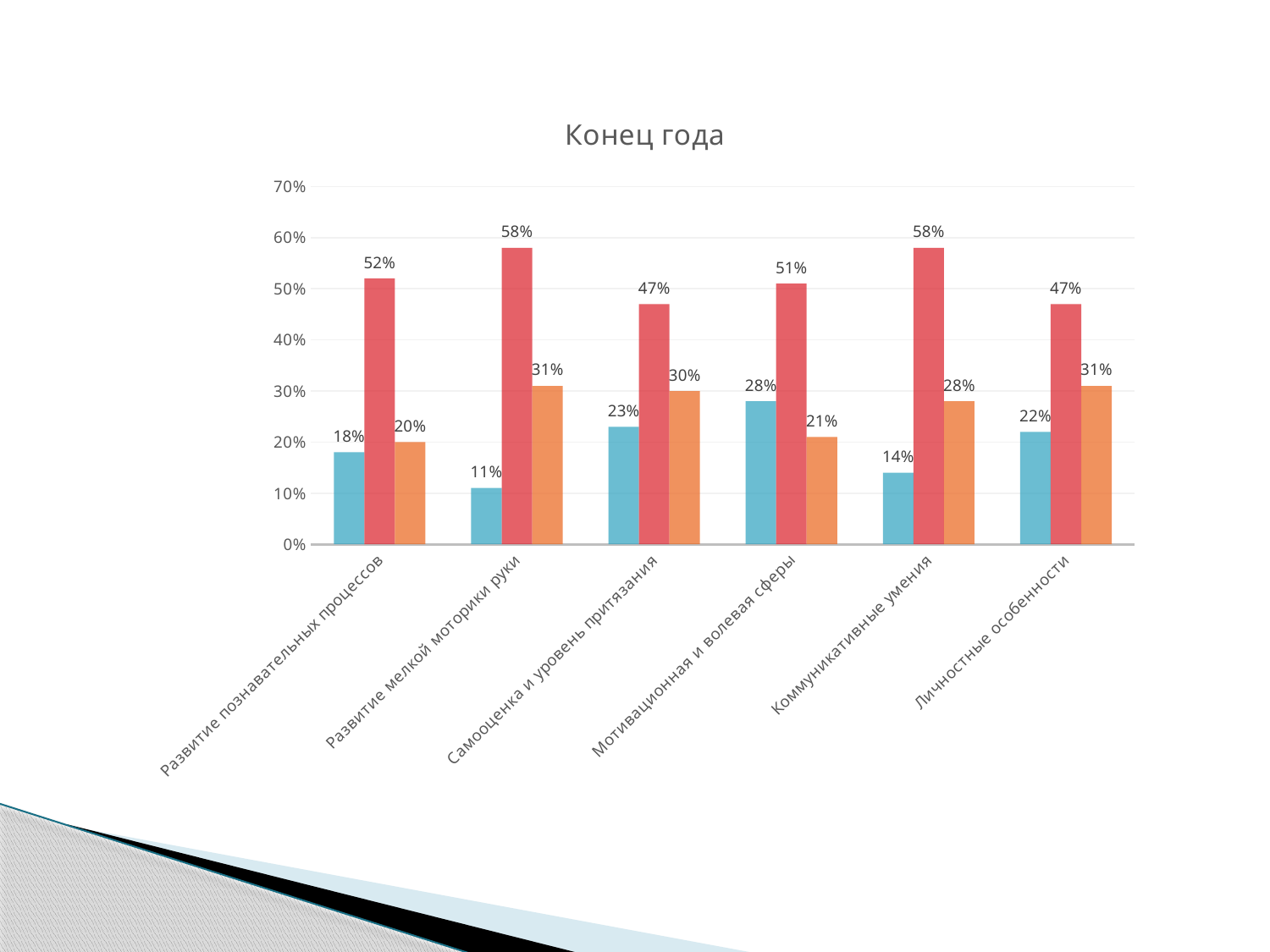
Which category has the lowest blue bar? Развитие мелкой моторики руки What is the difference between the red bar and the blue bar for Коммуникативные умения? 44% Which category has the highest orange bar? Развитие мелкой моторики руки and Личностные особенности (both 31%) What is the value of the orange bar for Личностные особенности? 31% How many categories are shown on the x axis of the chart? 6 Is the red bar for Развитие познавательных процессов greater or less than 50%? greater Which is larger for Самооценка и уровень притязания: the blue bar or the orange bar? the orange bar What is the title of the chart? Конец года What is the value of the red bar for Развитие мелкой моторики руки? 58% What is the value of the blue bar for Мотивационная и волевая сферы? 28% How many bars are shown for each category? 3 What kind of chart is shown on the slide? bar chart